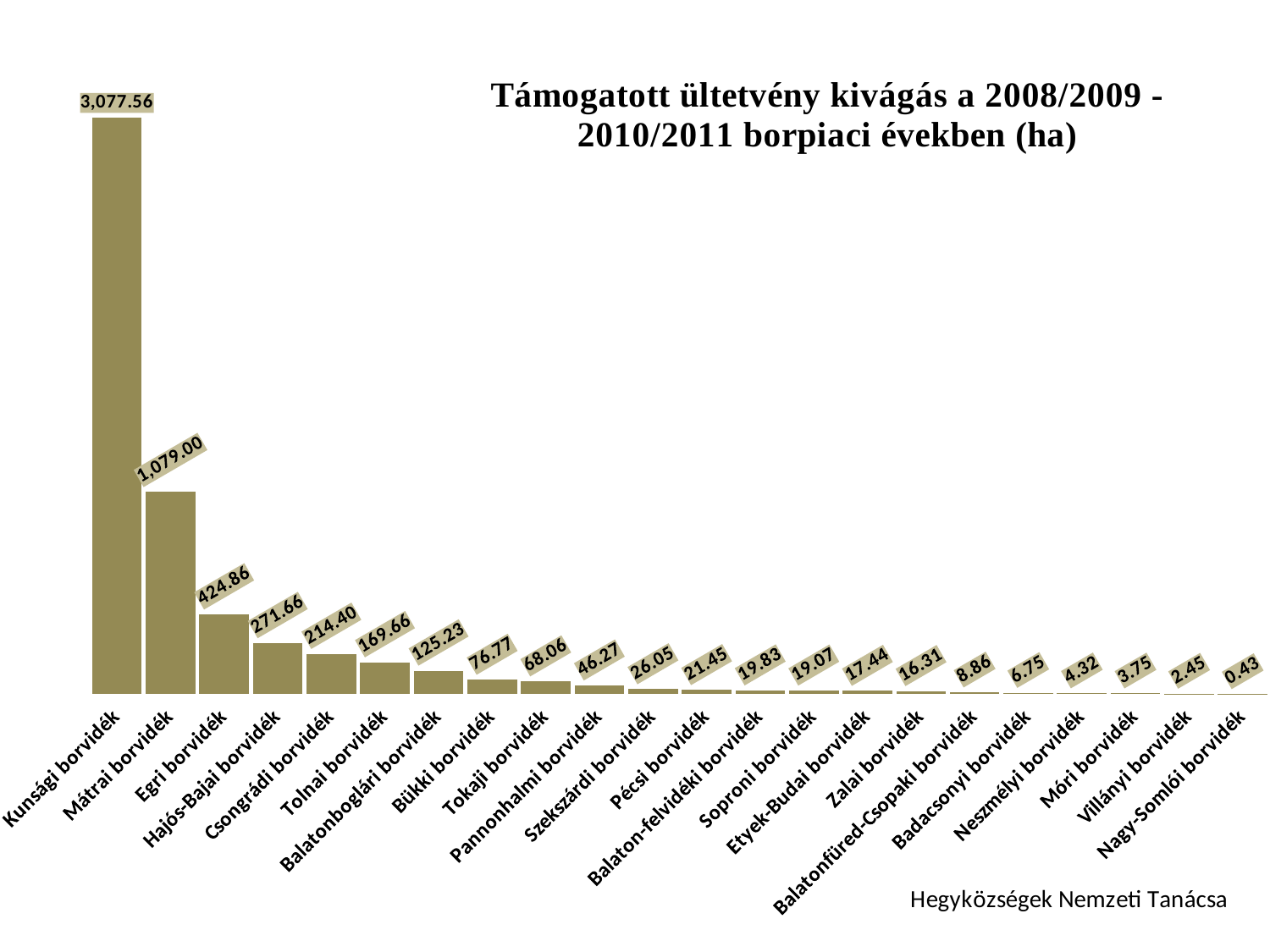
What kind of chart is shown on the slide? Bar chart What is the difference between the values for Egri borvidék and Hajós-Bajai borvidék? 153.20 How many wine regions are shown on the chart? 22 Which wine region has the highest value? Kunsági borvidék Which wine region has the lowest value? Nagy-Somlói borvidék What is the value for Tokaji borvidék? 68.06 What is the value for Villányi borvidék? 2.45 Which is larger, the value for Csongrádi borvidék or Tolnai borvidék? Csongrádi borvidék What is the difference between the values for Kunsági borvidék and Mátrai borvidék? 1,998.56 What is the value for Egri borvidék? 424.86 Do the values rise or fall from left to right along the x axis? Fall What is the value for Kunsági borvidék? 3,077.56